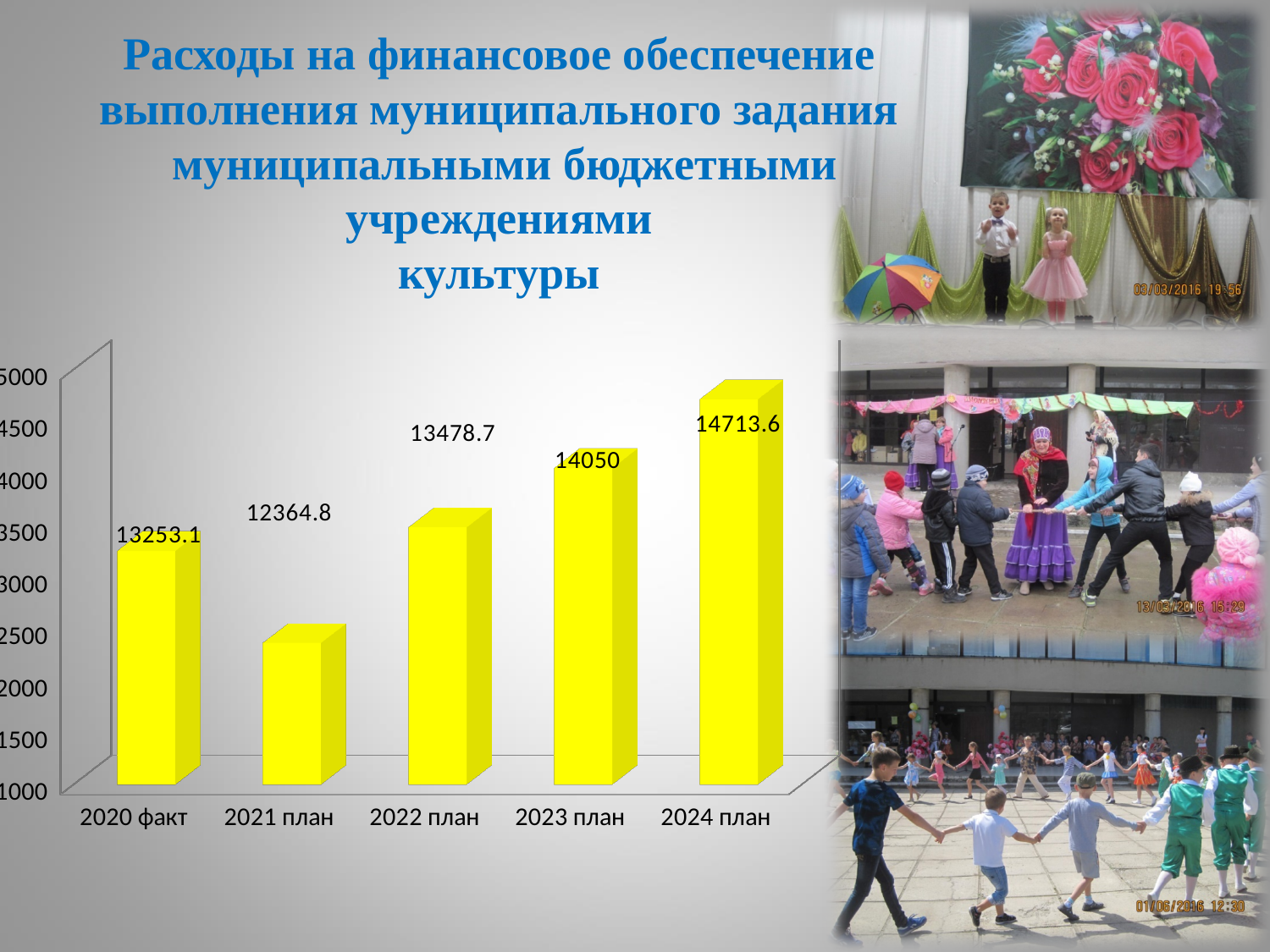
What kind of chart is shown on the slide? Bar chart What is the value for 2022 план? 13478.7 Which category has the lowest value? 2021 план Do the values rise or fall from 2021 план to 2024 план? Rise Which is larger, the value for 2020 факт or the value for 2022 план? 2022 план What is the value for 2024 план? 14713.6 What is the difference between the values for 2024 план and 2023 план? 663.6 What is the value for 2020 факт? 13253.1 What is the value for 2023 план? 14050 Which category has the highest value? 2024 план How many categories are shown on the x axis? 5 What is the value for 2021 план? 12364.8